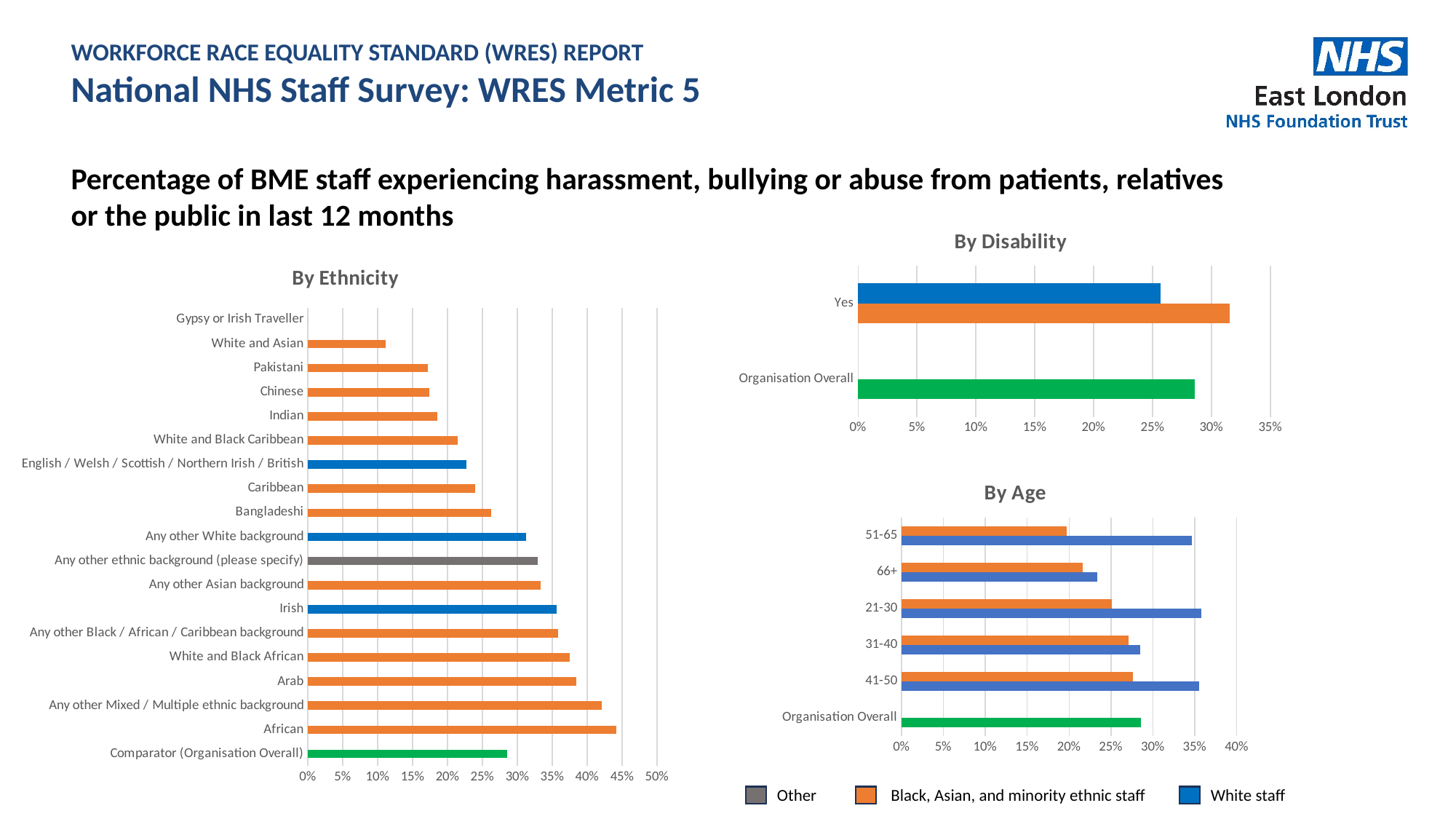
How many series does the legend at the bottom of the slide list? 3 In the By Ethnicity chart, is the value for African greater or less than 40%? greater In the By Disability chart, for the Yes category, which is larger: the value for Black, Asian, and minority ethnic staff or the value for White staff? Black, Asian, and minority ethnic staff What kind of chart is the By Ethnicity chart? bar chart In the By Ethnicity chart, is the value for Comparator (Organisation Overall) greater or less than 25%? greater In the By Ethnicity chart, is the value for White and Asian greater or less than 15%? less In the By Ethnicity chart, which category has the longest bar? African In the By Ethnicity chart, which is larger: the value for Arab or the value for Indian? Arab How many categories are listed on the y axis of the By Ethnicity chart? 19 In the By Age chart, for the 51-65 category, which is larger: the value for White staff or the value for Black, Asian, and minority ethnic staff? White staff